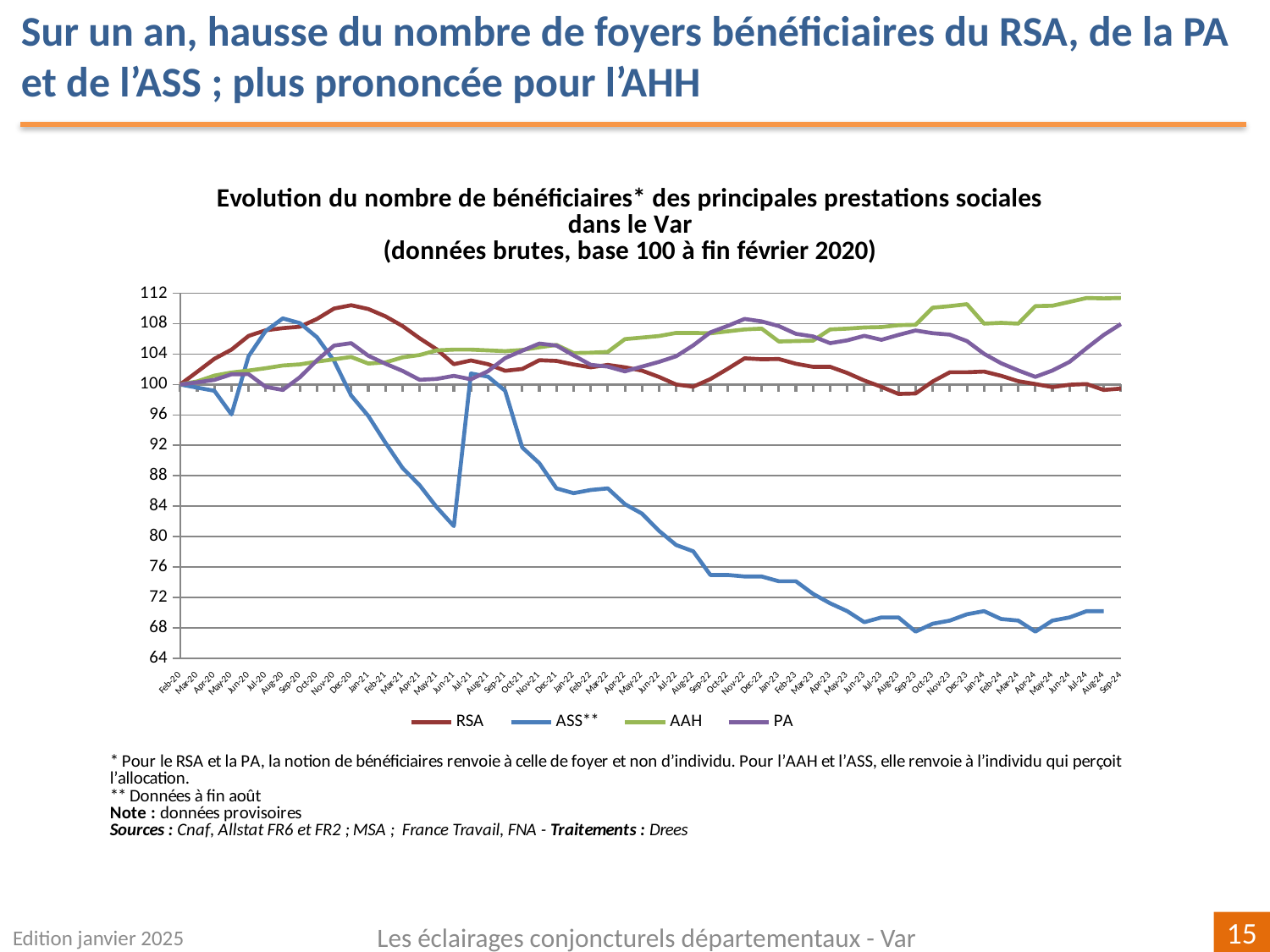
Which series are listed in the legend? RSA, ASS**, AAH, PA Overall, does the ASS** series rise or fall from Feb-20 to Sep-24? fall Is the value for AAH at Sep-24 greater or less than 108? greater How many series does the legend list? 4 Which series has the lowest value at Sep-24? RSA What kind of chart is shown on the slide? Line chart Which series has the highest value at Sep-24? AAH Is the value for RSA at Dec-20 greater or less than 108? greater What is the value of every series at Feb-20, the base month? 100 At Sep-24, which is larger, the value for AAH or the value for RSA? AAH Is the value for PA at Nov-22 greater or less than 104? greater